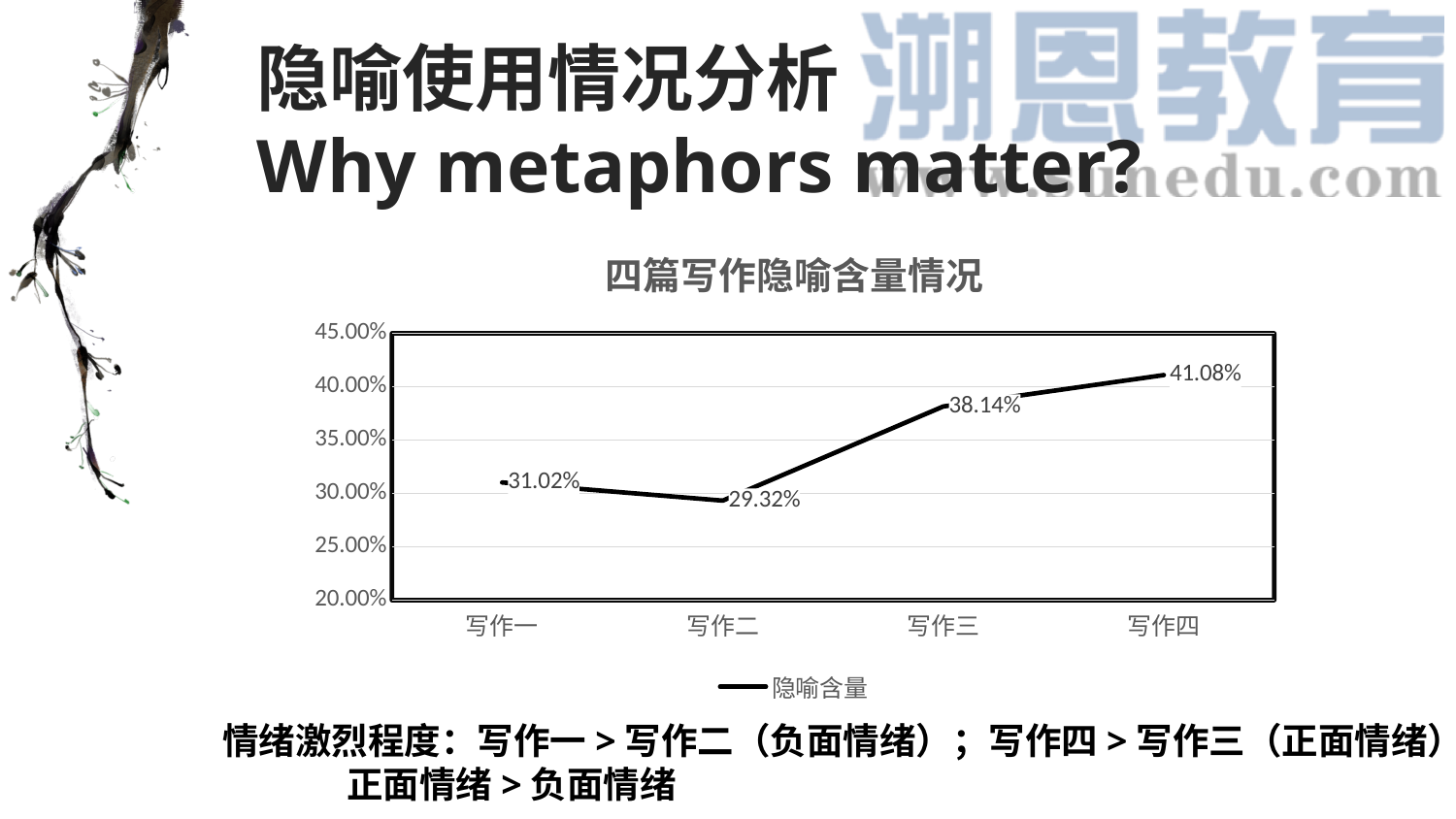
What is the title of the chart? 四篇写作隐喻含量情况 Which is larger, the value for 写作一 or the value for 写作二? 写作一 What is the difference between the values for 写作四 and 写作三? 2.94% Which category has the highest value? 写作四 What kind of chart is shown on the slide? line chart What is the value for 写作一? 31.02% How many categories are shown on the x axis? 4 What is the value for 写作三? 38.14% What is the value for 写作四? 41.08% Is the value for 写作三 greater or less than 35.00%? greater What is the value for 写作二? 29.32% Which category has the lowest value? 写作二